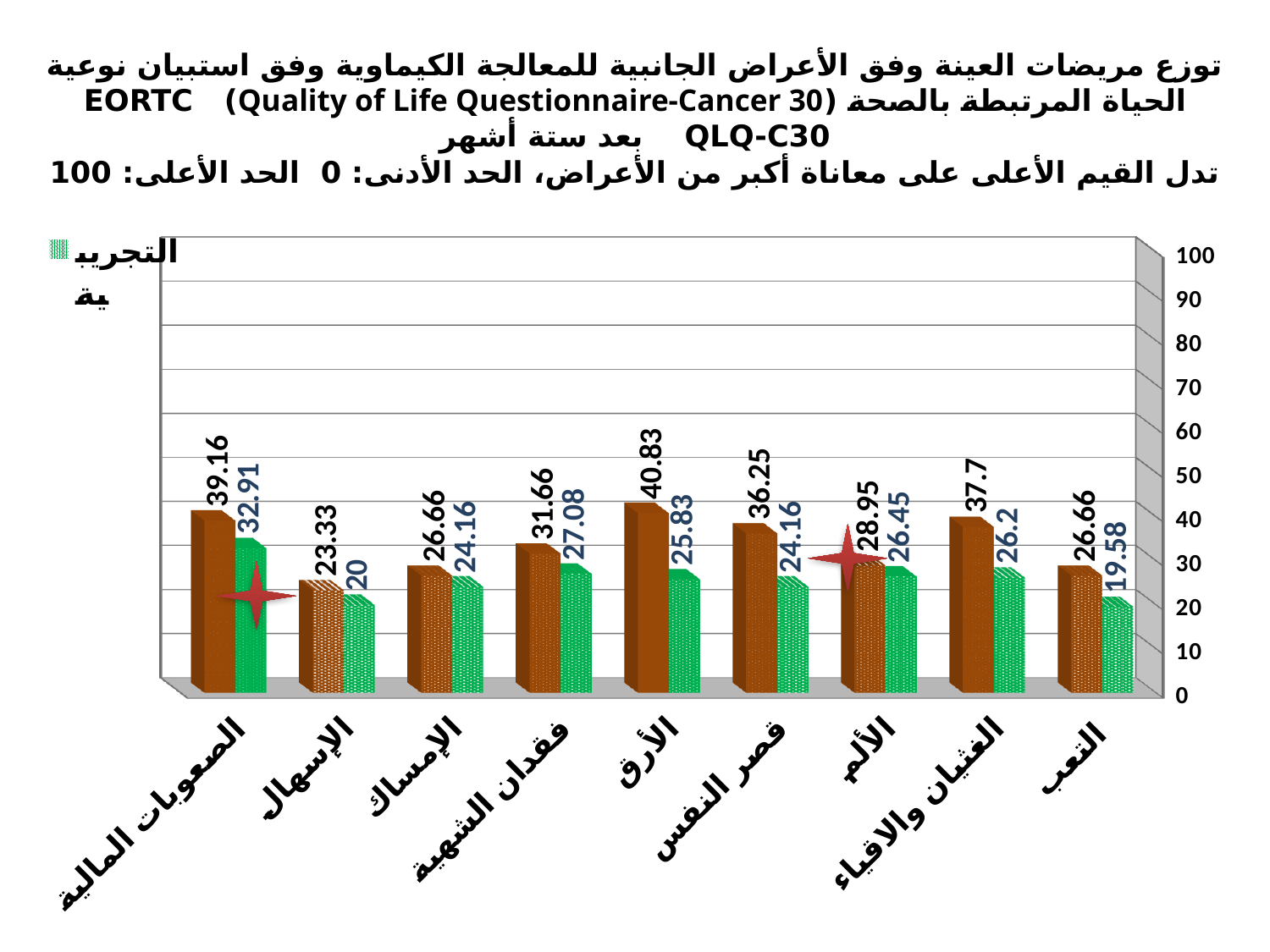
How many symptom categories are shown on the x axis? 9 What is the maximum value shown on the vertical axis? 100 What is the value of the green (التجريبية) bar for التعب? 19.58 Which category has the lowest green (التجريبية) bar? التعب What is the difference between the brown and green bars for الأرق? 15 Which category has the highest brown bar? الأرق What is the value of the green (التجريبية) bar for الصعوبات المالية? 32.91 What type of chart is shown on the slide? bar chart What is the value of the brown bar for الغثيان والاقياء? 37.7 Is the brown bar for قصر النفس greater or less than 30? greater Which is larger for الإسهال, the brown bar or the green (التجريبية) bar? the brown bar What is the value of the brown bar for الأرق? 40.83